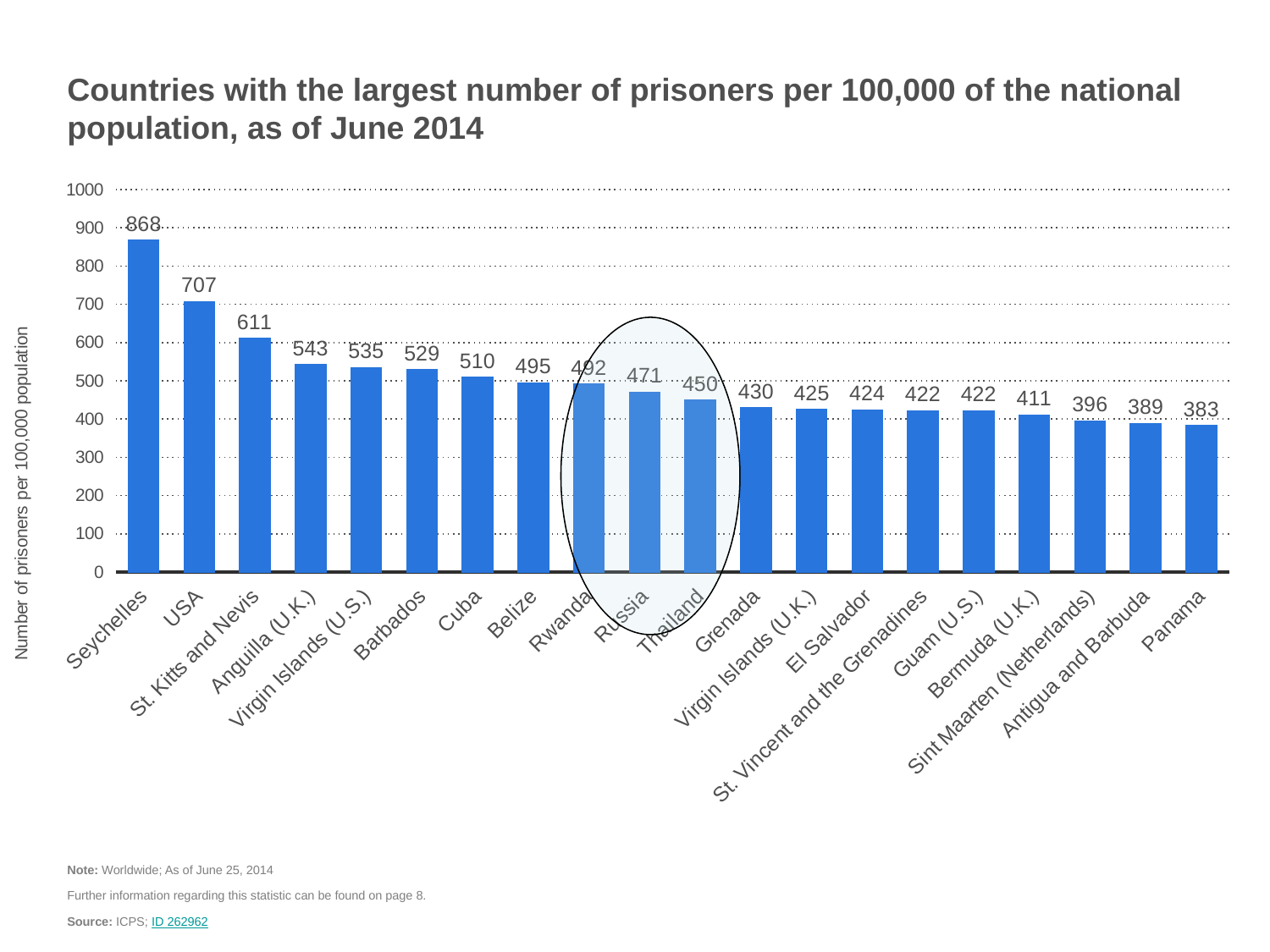
Is the value for St. Kitts and Nevis greater or less than 600? greater What is the number of prisoners per 100,000 population for the USA? 707 What is the difference between the values for Cuba and Thailand? 60 Do the values rise or fall from left to right along the x axis? Fall What is the value shown for Sint Maarten (Netherlands)? 396 What is the value shown for Russia? 471 How many countries are shown on the chart? 20 What is the difference between the values for Seychelles and the USA? 161 Which has a higher value, Barbados or Belize? Barbados What type of chart is shown on the slide? Bar chart Which country has the highest number of prisoners per 100,000 population? Seychelles Which country has the lowest value on the chart? Panama